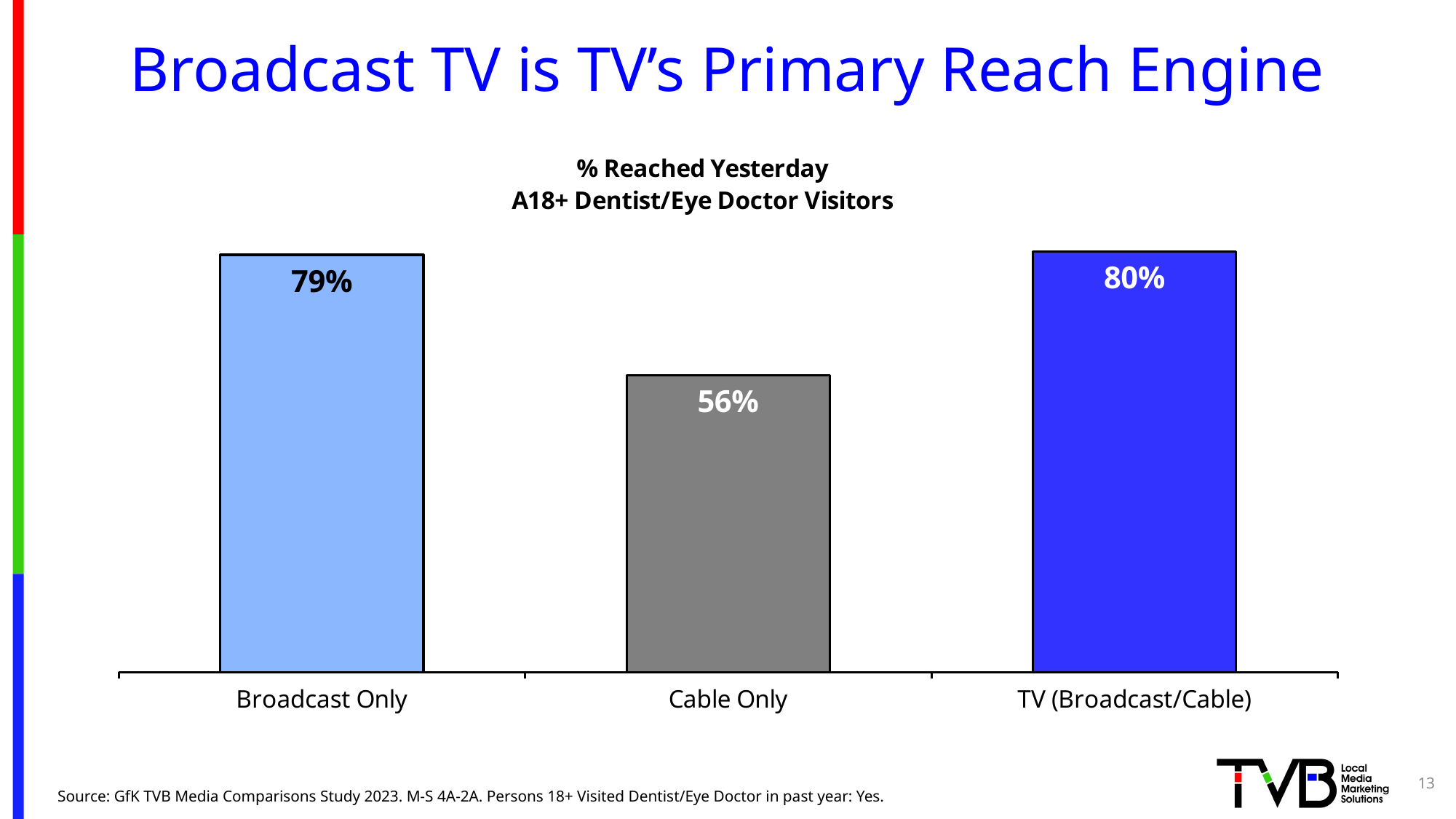
Which category has the lowest value? Cable Only What is the value for TV (Broadcast/Cable)? 80% What kind of chart is shown on the slide? Bar chart What colour is the bar for Cable Only? Gray Which is larger, the value for Broadcast Only or the value for Cable Only? Broadcast Only What is the title of the chart? % Reached Yesterday A18+ Dentist/Eye Doctor Visitors Which category has the highest value? TV (Broadcast/Cable) What is the difference between the values for Broadcast Only and Cable Only? 23% What is the value for Cable Only? 56% What is the value for Broadcast Only? 79% What is the difference between the values for TV (Broadcast/Cable) and Cable Only? 24% How many categories are shown on the chart? 3